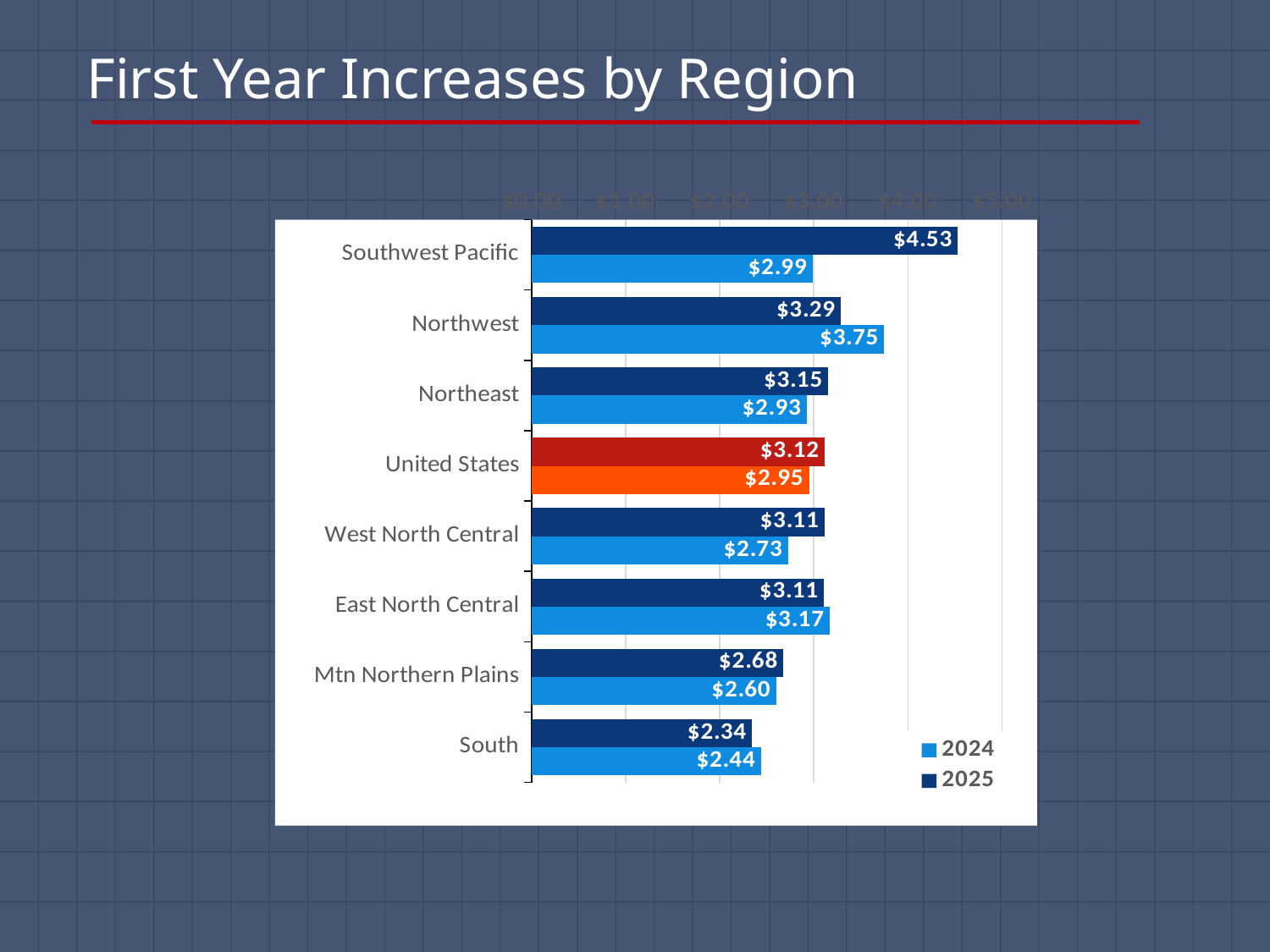
What kind of chart is shown on the slide? Bar chart Which region has the highest 2025 value? Southwest Pacific How many series does the legend list? 2 How many regions are shown on the chart? 8 What is the 2024 value for Northwest? $3.75 Is the 2025 value for South greater or less than $3.00? less What is the difference between the 2025 and 2024 values for Southwest Pacific? $1.54 Which is larger for Northwest, the 2024 value or the 2025 value? 2024 What is the 2024 value for United States? $2.95 What is the title of the slide? First Year Increases by Region What is the 2025 value for Southwest Pacific? $4.53 Which region has the lowest 2024 value? South